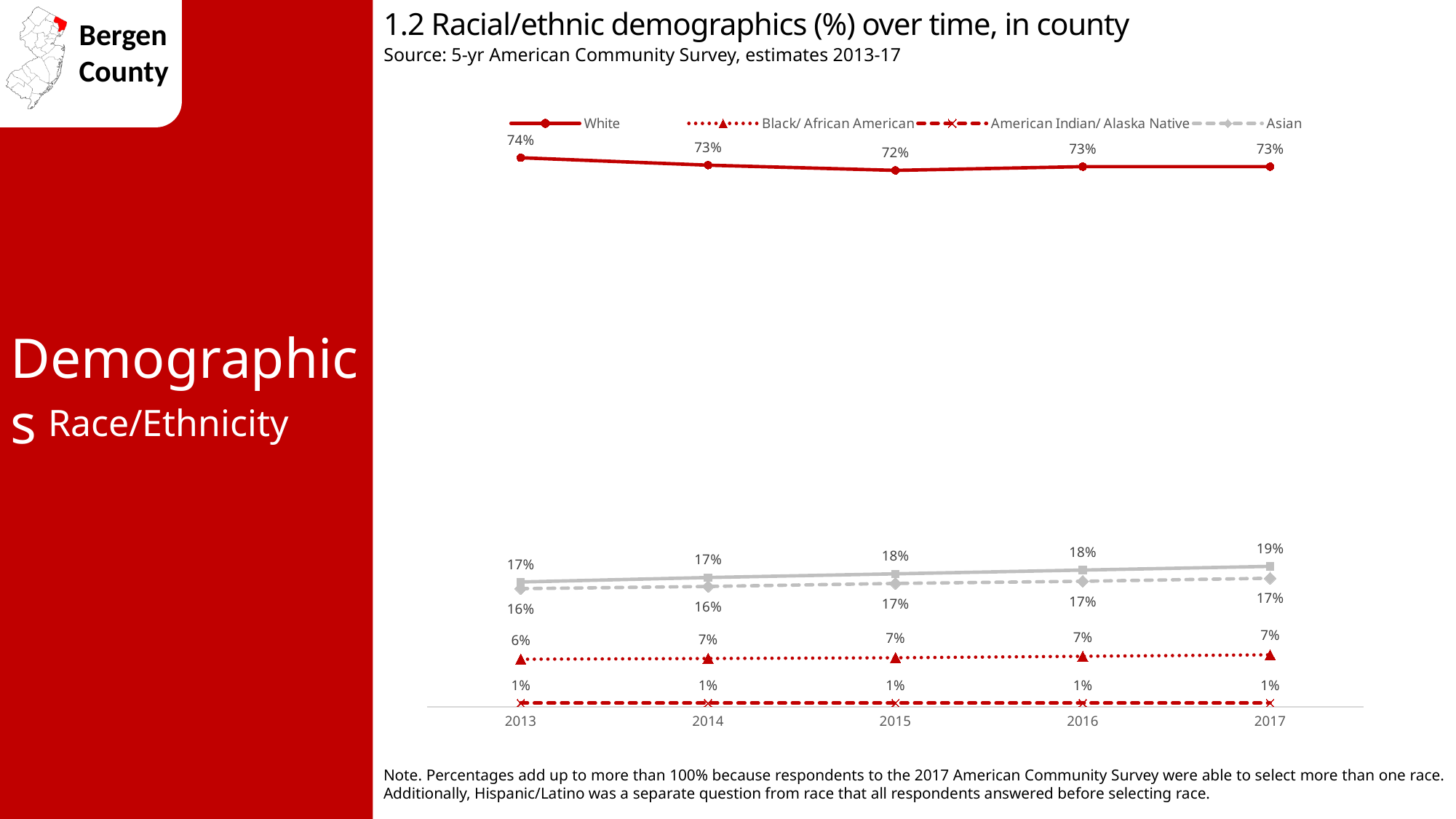
What is the value for White in 2013? 74% What is the value for American Indian/ Alaska Native in 2016? 1% Which is larger in 2013, the Asian value or the Black/ African American value? Asian What is the difference between the White value in 2013 and in 2015? 2 percentage points What kind of chart is shown on the slide? Line chart What is the value for Black/ African American in 2013? 6% What is the value for Asian in 2017? 17% In which year is the White percentage highest? 2013 In which year is the White percentage lowest? 2015 What is the value for White in 2015? 72% Does the Asian percentage rise or fall from 2013 to 2017? Rise How many years are shown on the x axis? 5